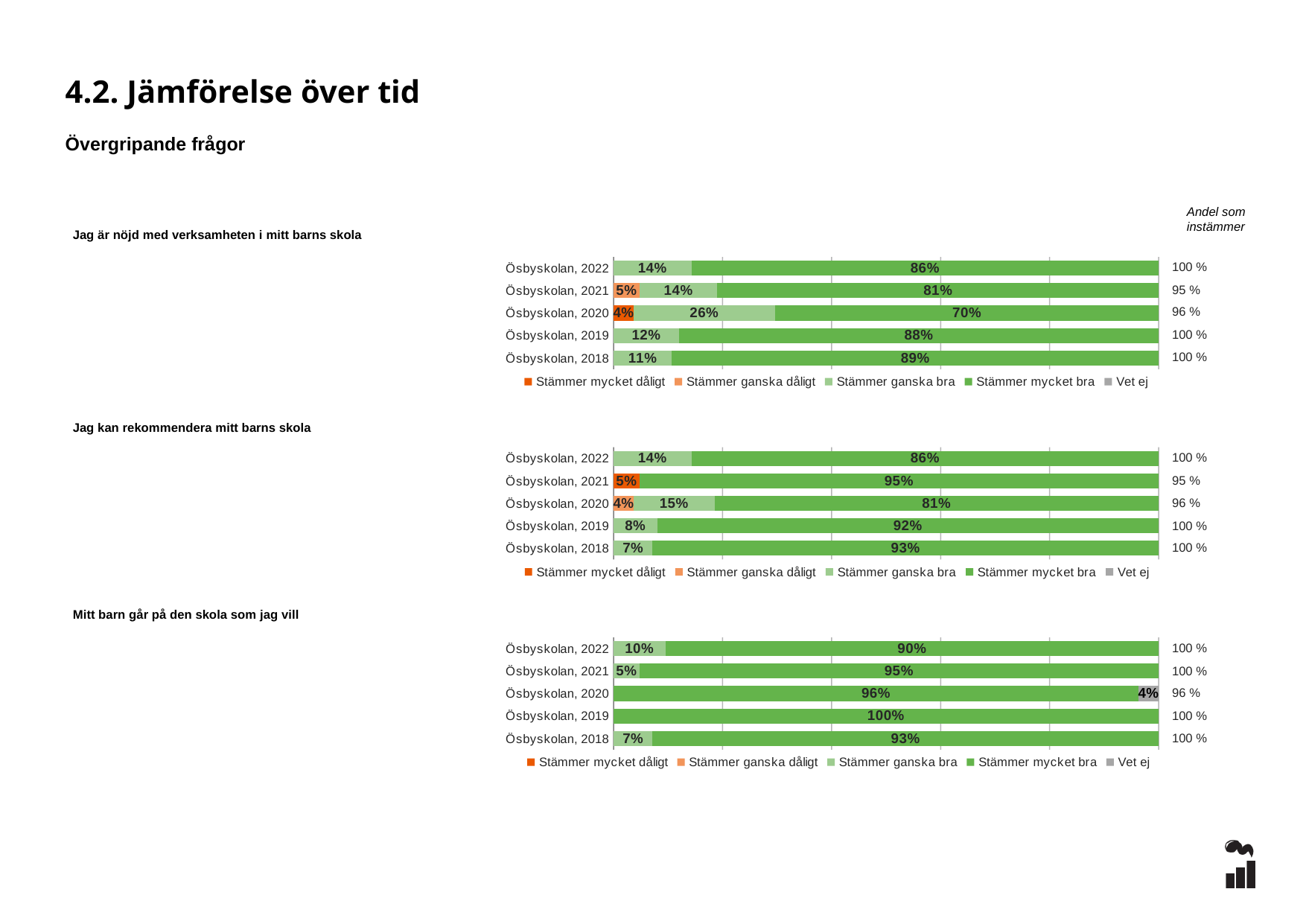
What kind of chart is used for 'Mitt barn går på den skola som jag vill'? Stacked bar chart In the chart 'Jag kan rekommendera mitt barns skola', what is the 'Stämmer mycket dåligt' value for Ösbyskolan, 2021? 5% How many series does the legend of the chart 'Jag kan rekommendera mitt barns skola' list? 5 In the chart 'Jag kan rekommendera mitt barns skola', is the 'Stämmer mycket bra' value larger for Ösbyskolan, 2019 or Ösbyskolan, 2018? Ösbyskolan, 2018 In the chart 'Jag är nöjd med verksamheten i mitt barns skola', what is the 'Andel som instämmer' value for Ösbyskolan, 2021? 95 % In the chart 'Jag är nöjd med verksamheten i mitt barns skola', which year has the highest 'Stämmer mycket bra' value? Ösbyskolan, 2018 In the chart 'Jag kan rekommendera mitt barns skola', which year has the lowest 'Stämmer mycket bra' value? Ösbyskolan, 2020 In the chart 'Jag är nöjd med verksamheten i mitt barns skola', what is the 'Stämmer mycket bra' value for Ösbyskolan, 2020? 70% In the chart 'Mitt barn går på den skola som jag vill', what is the 'Vet ej' value for Ösbyskolan, 2020? 4% In the chart 'Mitt barn går på den skola som jag vill', which year has the highest 'Stämmer mycket bra' value? Ösbyskolan, 2019 In the chart 'Jag är nöjd med verksamheten i mitt barns skola', what is the difference between the 'Stämmer ganska bra' values for Ösbyskolan, 2020 and Ösbyskolan, 2019? 14% In the chart 'Mitt barn går på den skola som jag vill', what is the difference between the 'Stämmer mycket bra' values for Ösbyskolan, 2021 and Ösbyskolan, 2022? 5%